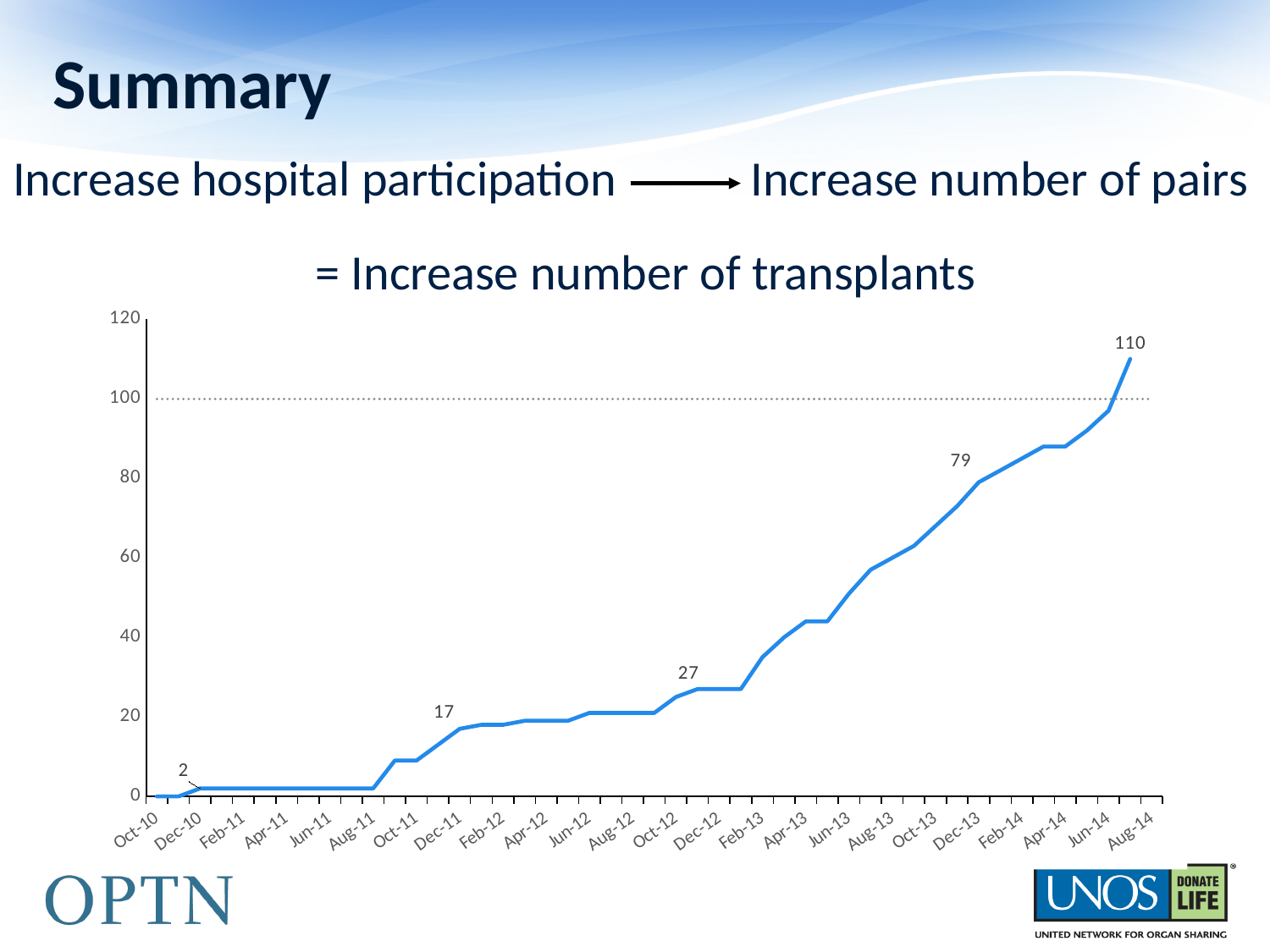
What is the difference between the labeled values at Dec-13 and Dec-12? 52 What value is labeled at Dec-11? 17 Is the value for Aug-13 greater or less than 40? greater Which labeled point has the highest value? Jul-14 (110) What value is labeled at Dec-10? 2 What value is labeled at Dec-12? 27 What kind of chart is shown on the slide? line chart Do the values rise or fall from Oct-10 to Aug-14? rise What value is labeled at Dec-13? 79 At what value is the dotted horizontal reference line drawn? 100